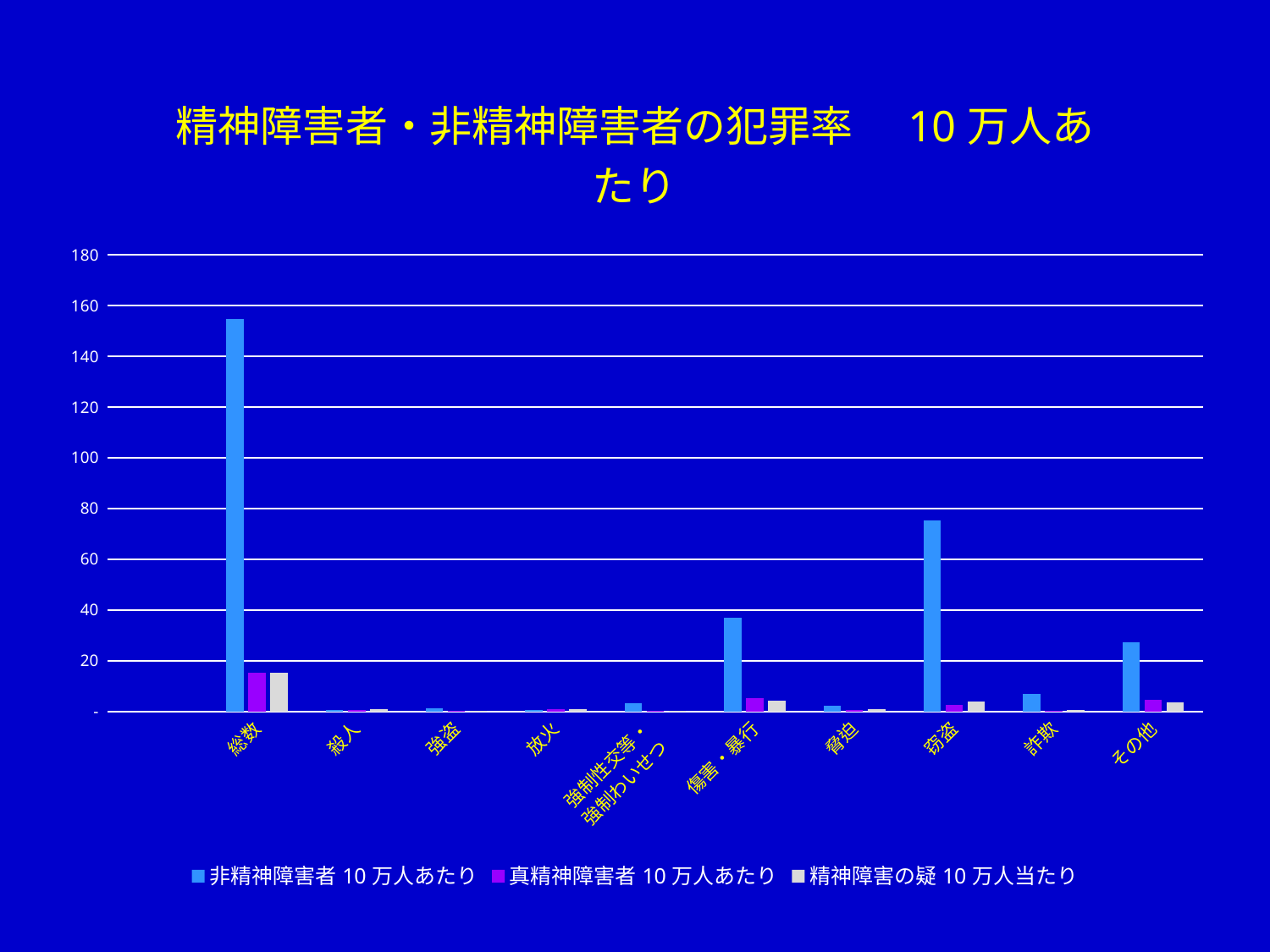
Which category has the highest value for the 非精神障害者 10 万人あたり series? 総数 In the 非精神障害者 10 万人あたり series, which is larger: 窃盗 or 傷害・暴行? 窃盗 How many series does the chart's legend list? 3 How many categories are shown on the x axis of the chart? 10 Which series is shown in magenta in the chart's legend? 真精神障害者 10 万人あたり Is the value for 傷害・暴行 in the 非精神障害者 10 万人あたり series greater or less than 40? less Is the value for 窃盗 in the 非精神障害者 10 万人あたり series greater or less than 60? greater What kind of chart is shown on the slide? bar chart Excluding 総数, which category has the highest value for the 非精神障害者 10 万人あたり series? 窃盗 Is the value for その他 in the 非精神障害者 10 万人あたり series greater or less than 20? greater